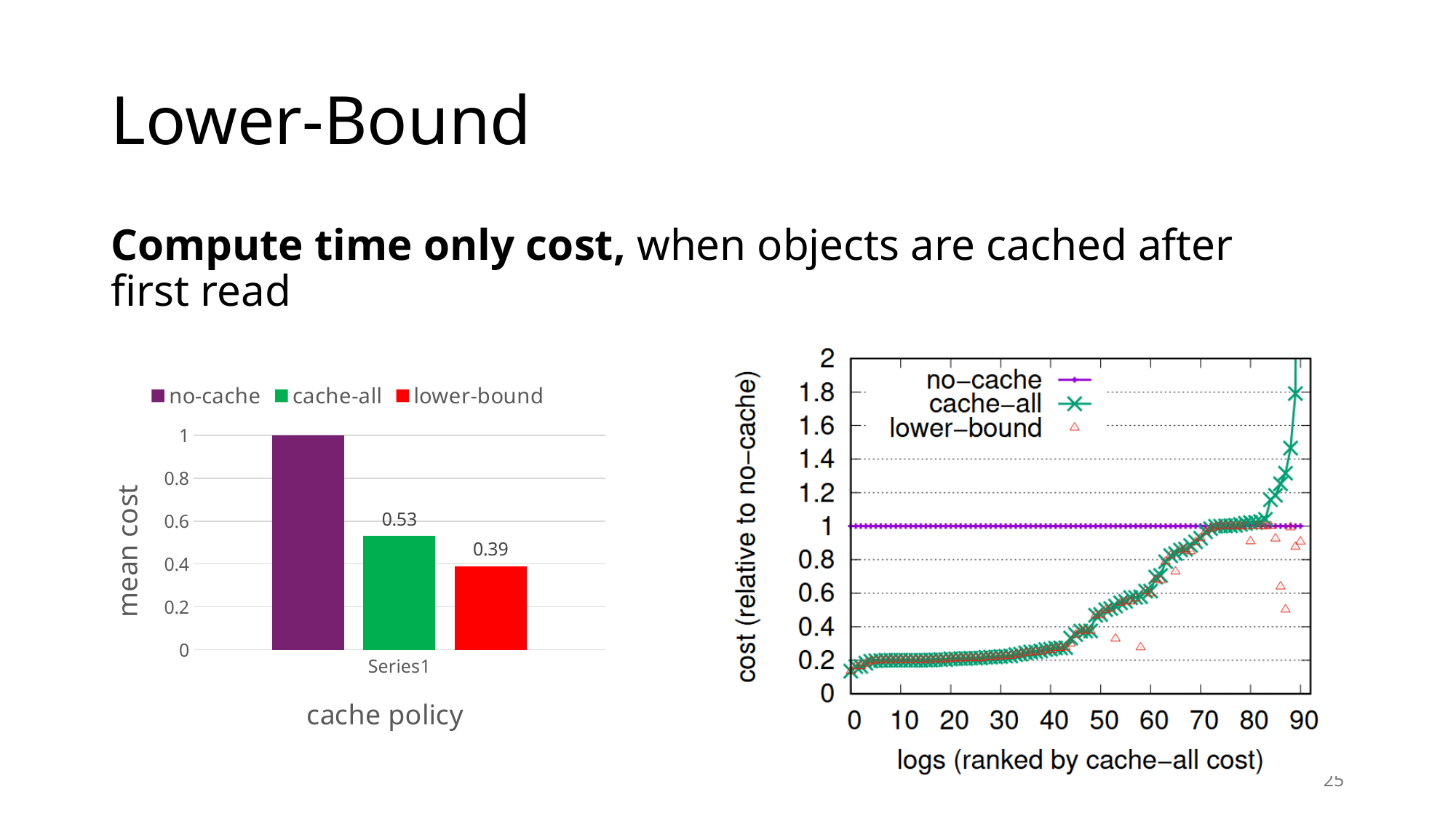
In the left bar chart, which cache policy has the highest mean cost? no-cache What kind of chart is the left chart on the slide? bar chart In the right chart, does the cache-all cost rise or fall as the log rank increases along the x axis? rise In the left bar chart, what is the mean cost for cache-all? 0.53 How many series does the legend of the left bar chart list? 3 In the left bar chart, is the mean cost for no-cache greater or less than 0.8? greater How many series does the legend of the right chart list? 3 What is the y-axis title of the left bar chart? mean cost In the left bar chart, which has a larger mean cost, cache-all or lower-bound? cache-all In the left bar chart, what is the mean cost for lower-bound? 0.39 In the left bar chart, what is the difference between the mean cost of cache-all and lower-bound? 0.14 In the left bar chart, which cache policy has the lowest mean cost? lower-bound